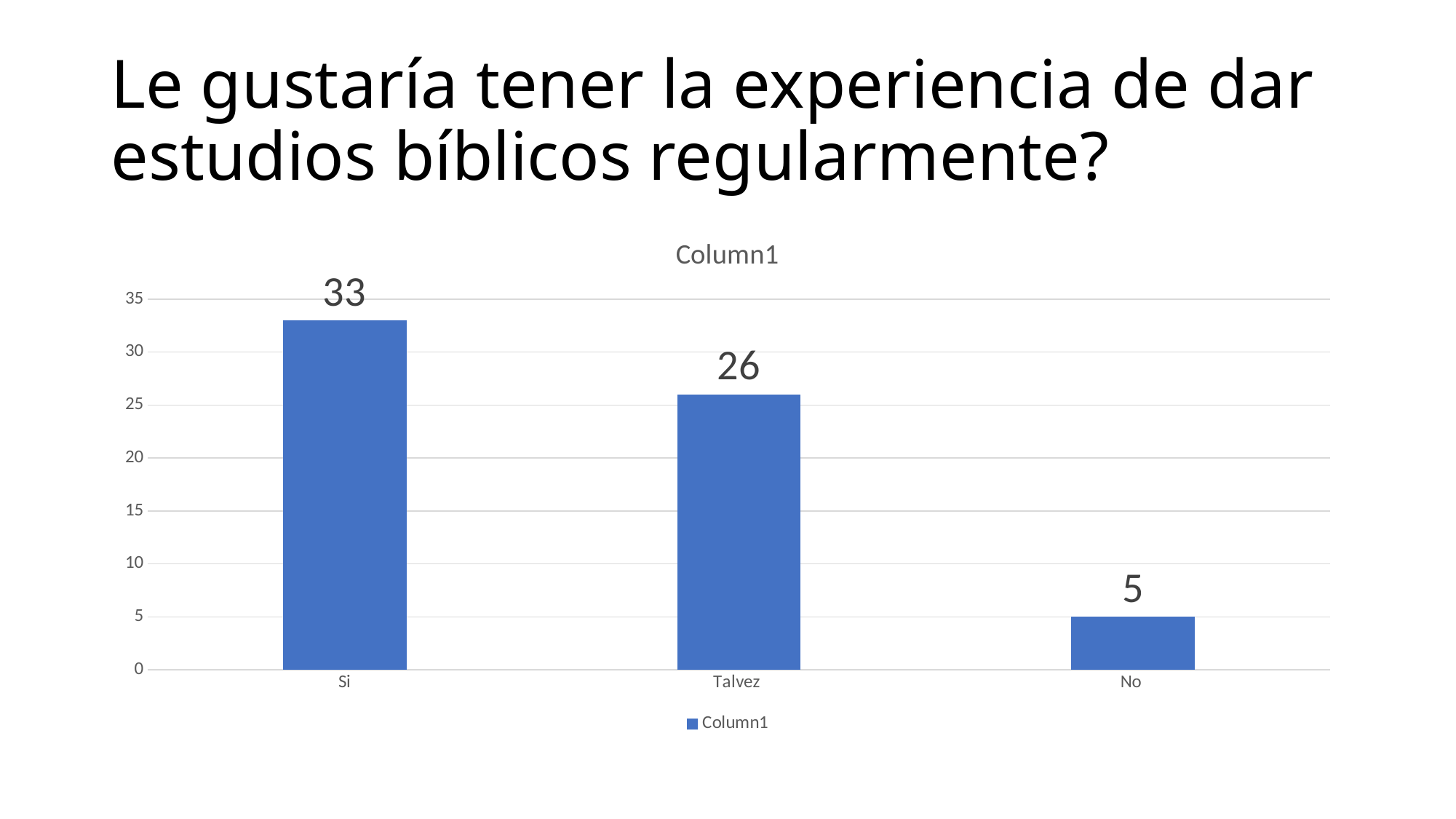
Which is larger, the value for Talvez or the value for No? Talvez Which category has the highest value? Si What is the value for Talvez? 26 What is the value for No? 5 What kind of chart is shown on the slide? bar chart What is the difference between the values for Talvez and No? 21 What is the title of the chart? Column1 What is the difference between the values for Si and Talvez? 7 Which category has the lowest value? No What is the value for Si? 33 Is the value for Si greater or less than 30? greater How many categories are shown on the x axis? 3